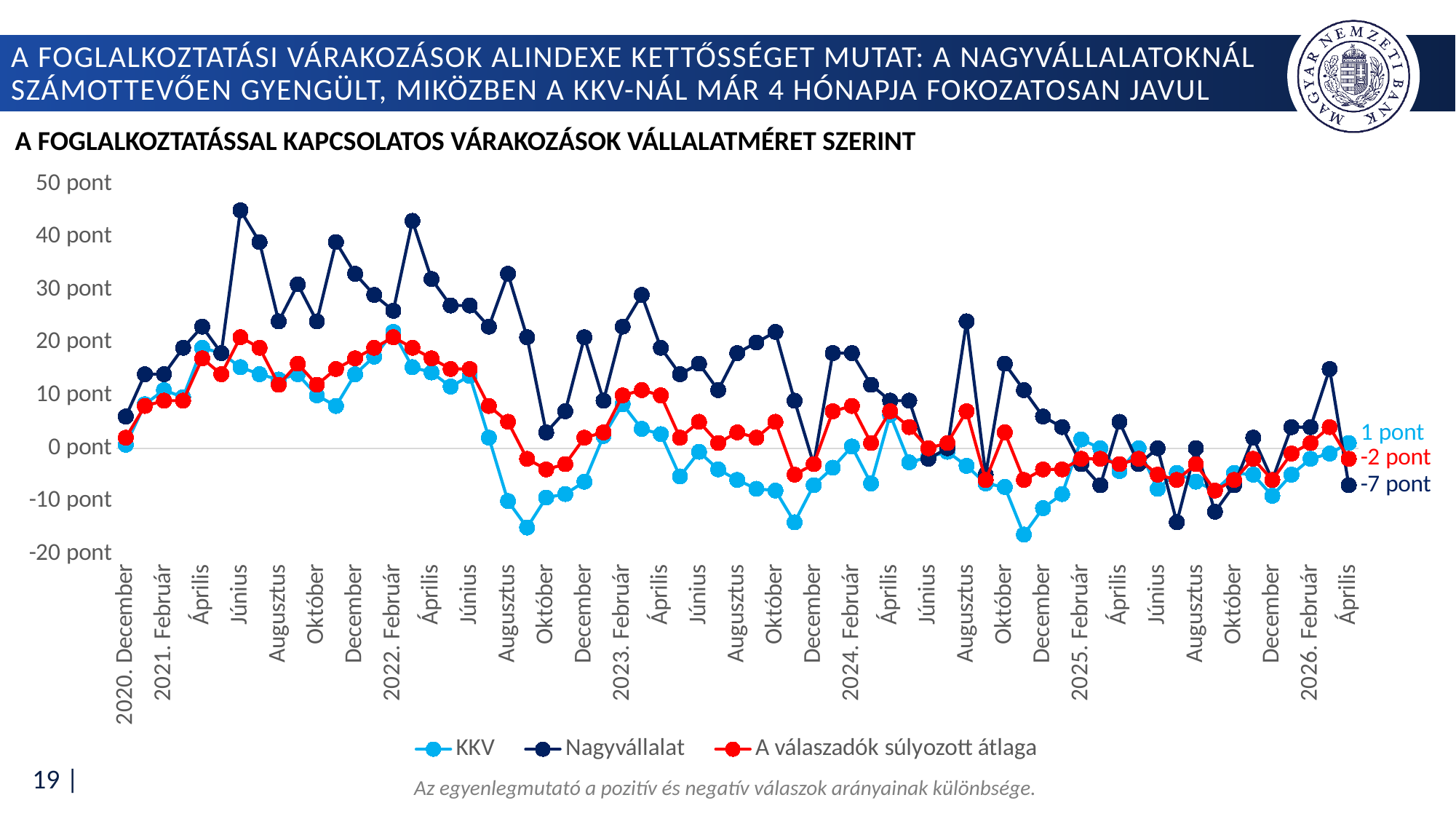
What is the value of the Nagyvállalat series at the last point (2026 Április)? -7 pont How many series does the legend list? 3 What is the title of the chart? A foglalkoztatással kapcsolatos várakozások vállalatméret szerint At the last point (2026 Április), which series has the highest value? KKV At the last point (2026 Április), which is larger: the KKV value or the Nagyvállalat value? KKV At the last point (2026 Április), what is the difference between the KKV value and the Nagyvállalat value? 8 pont What is the value of 'A válaszadók súlyozott átlaga' at the last point (2026 Április)? -2 pont What is the value of the KKV series at the last point (2026 Április)? 1 pont What kind of chart is shown on the slide? line chart At the last point (2026 Április), which series has the lowest value? Nagyvállalat Is the Nagyvállalat value in 2021 Június greater or less than 40 pont? greater